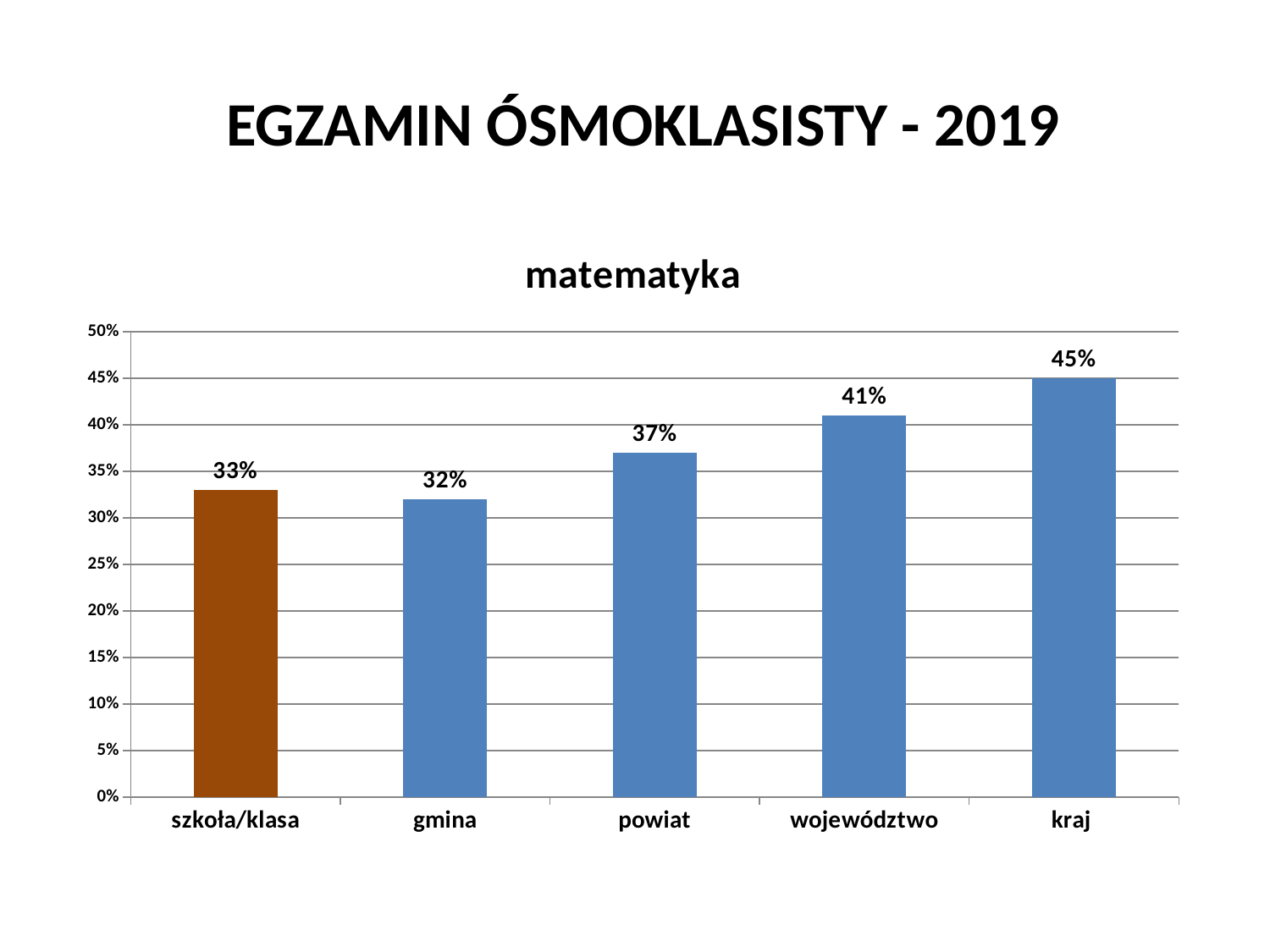
Which category has the highest value? kraj What is the title of the chart? matematyka Which is larger, the value for powiat or the value for województwo? województwo How many categories are shown in the chart? 5 What is the value for szkoła/klasa in the matematyka chart? 33% What is the value for gmina? 32% What is the difference between the values for kraj and szkoła/klasa? 12% What is the value for województwo? 41% Which category has the lowest value? gmina What is the value for powiat? 37% What is the value for kraj? 45% What kind of chart is shown on the slide? bar chart